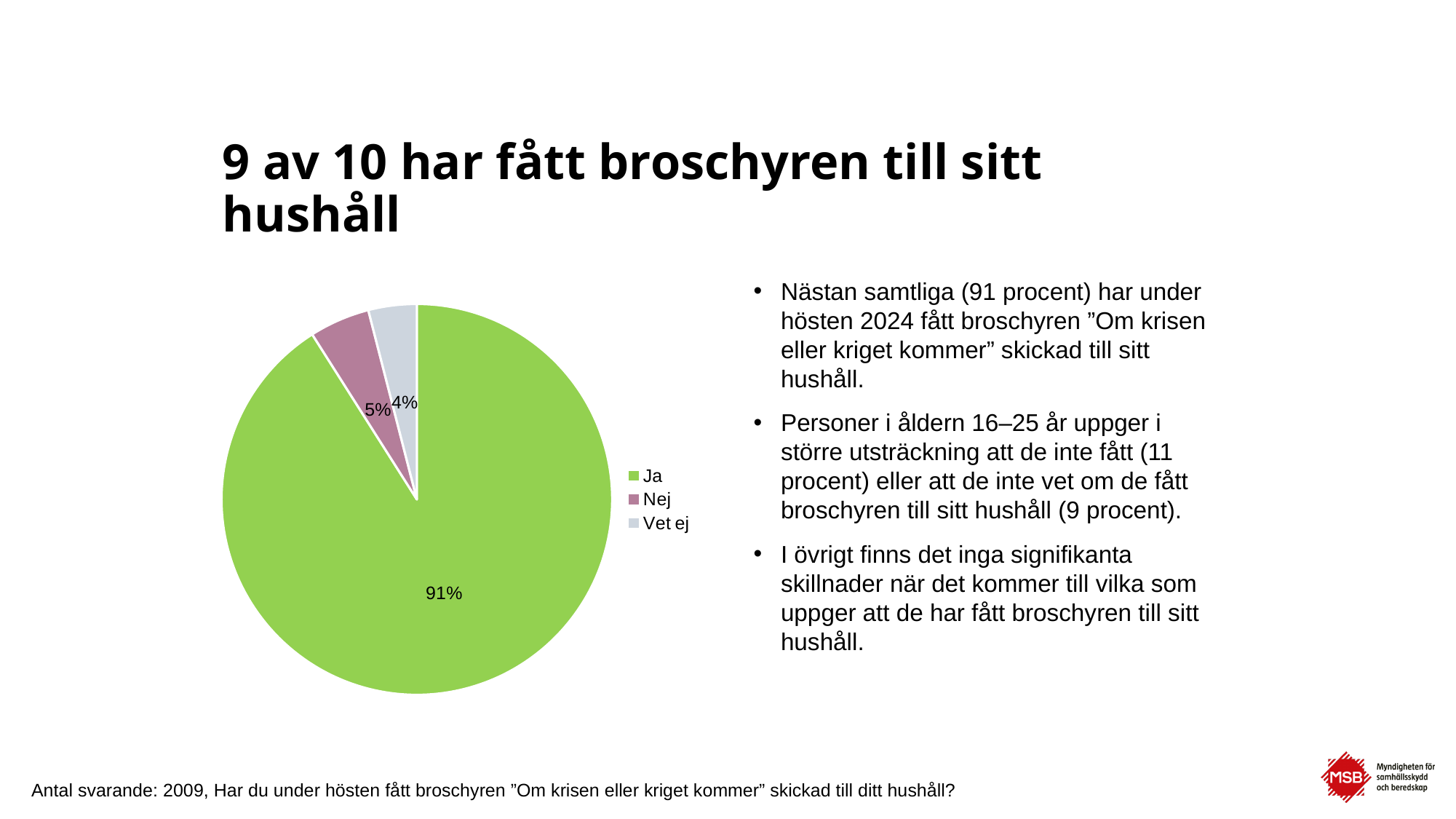
What is the difference between the "Nej" and "Vet ej" values? 1% What is the value shown for "Vet ej"? 4% What is the value shown for "Nej"? 5% What kind of chart is shown on the slide? pie chart Which category has the smallest slice of the pie? Vet ej What colour is the "Ja" slice in the pie chart? green How many categories does the pie chart have? 3 Which category has the largest slice of the pie? Ja Which is larger, the value for "Ja" or the value for "Nej"? Ja How many entries does the legend list? 3 What share of the pie does "Ja" represent? 91% What is the difference between the "Ja" and "Nej" values? 86%